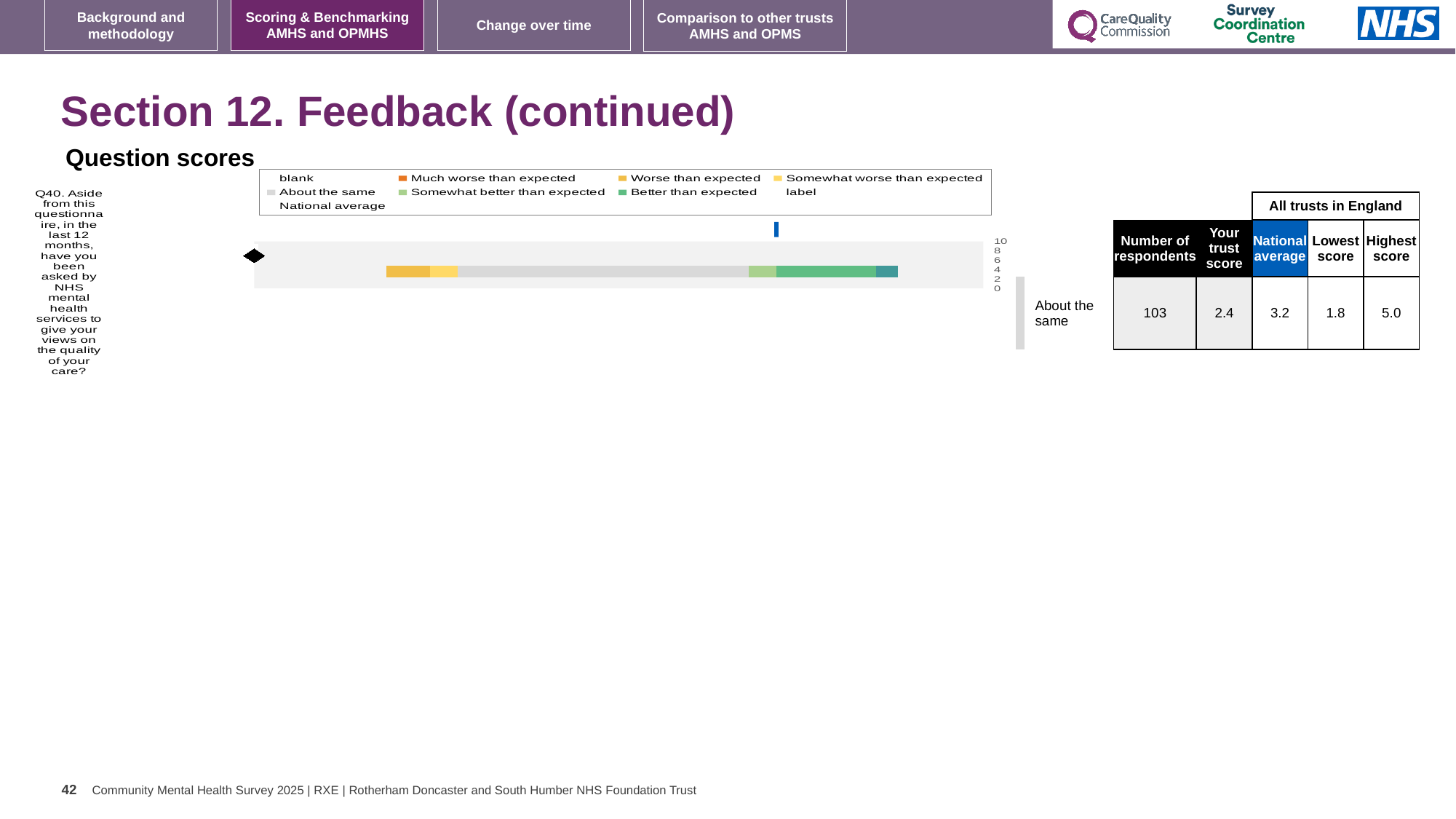
What is the trust's score for Q40 shown in the table beside the chart? 2.4 How many questions (categories) are plotted in the chart? 1 Which benchmark category is the trust's score for Q40 placed in, according to the label beside the chart? About the same What colour represents 'Better than expected' in the chart legend? green How many respondents answered Q40, according to the table beside the chart? 103 Which is larger for Q40: the trust's score or the national average? national average What is the national average score for Q40 shown in the table beside the chart? 3.2 What is the highest score among all trusts in England for Q40, as shown in the table beside the chart? 5.0 What kind of chart is shown on the slide? bar chart What is the difference between the highest score (5.0) and the lowest score (1.8) for Q40 in the table beside the chart? 3.2 Which question number is plotted in the chart? Q40 How many entries does the chart legend list? 9